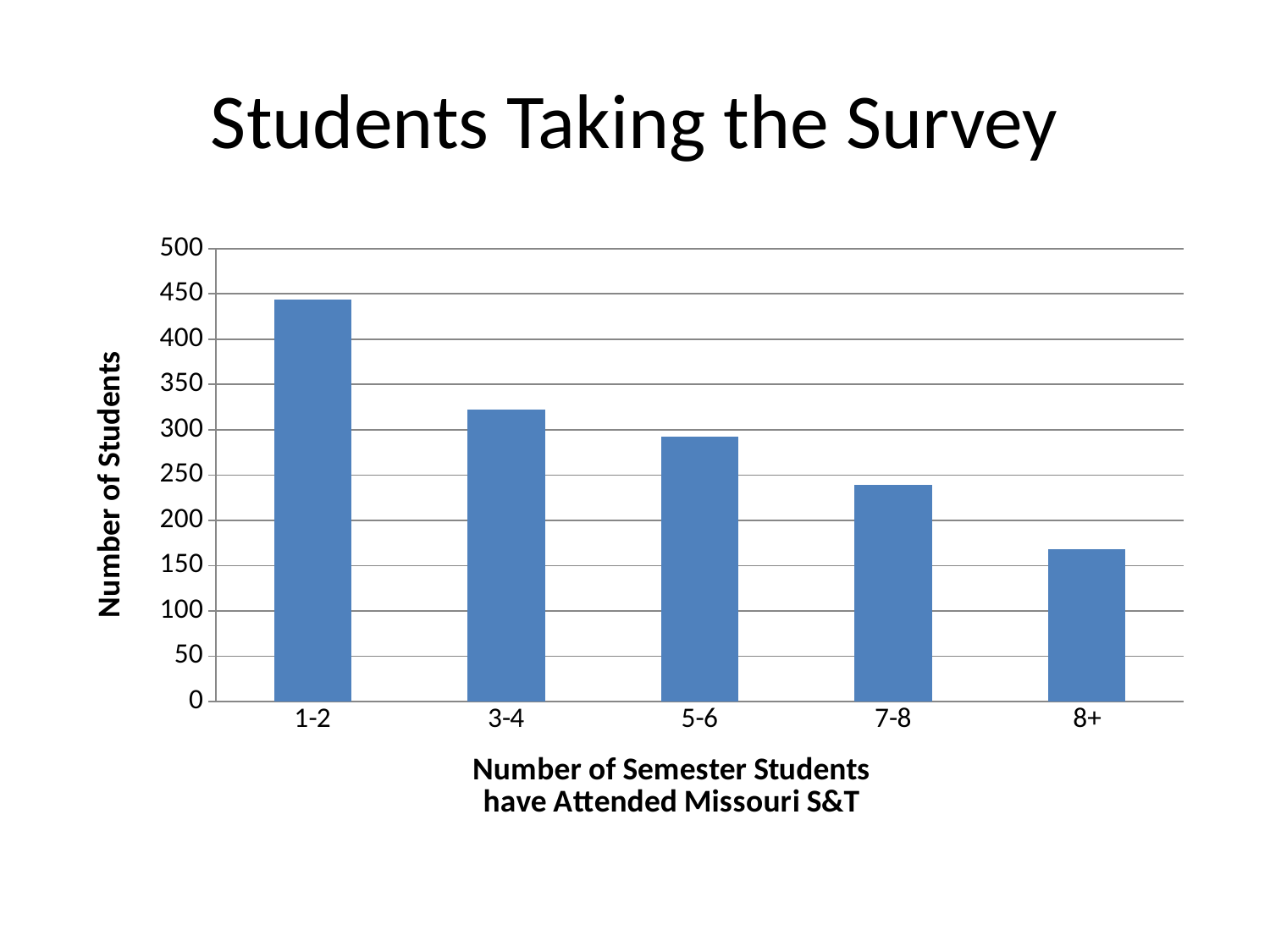
Is the value for 7-8 greater or less than 250? less Do the values rise or fall moving from 1-2 to 8+ along the x axis? fall Which has more students, 3-4 or 7-8? 3-4 What is the label of the y axis? Number of Students Is the value for 5-6 greater or less than 250? greater Is the value for 1-2 greater or less than 400? greater How many categories are shown on the x axis? 5 Which category has the lowest number of students? 8+ Which category has the highest number of students? 1-2 What kind of chart is shown on the slide? bar chart